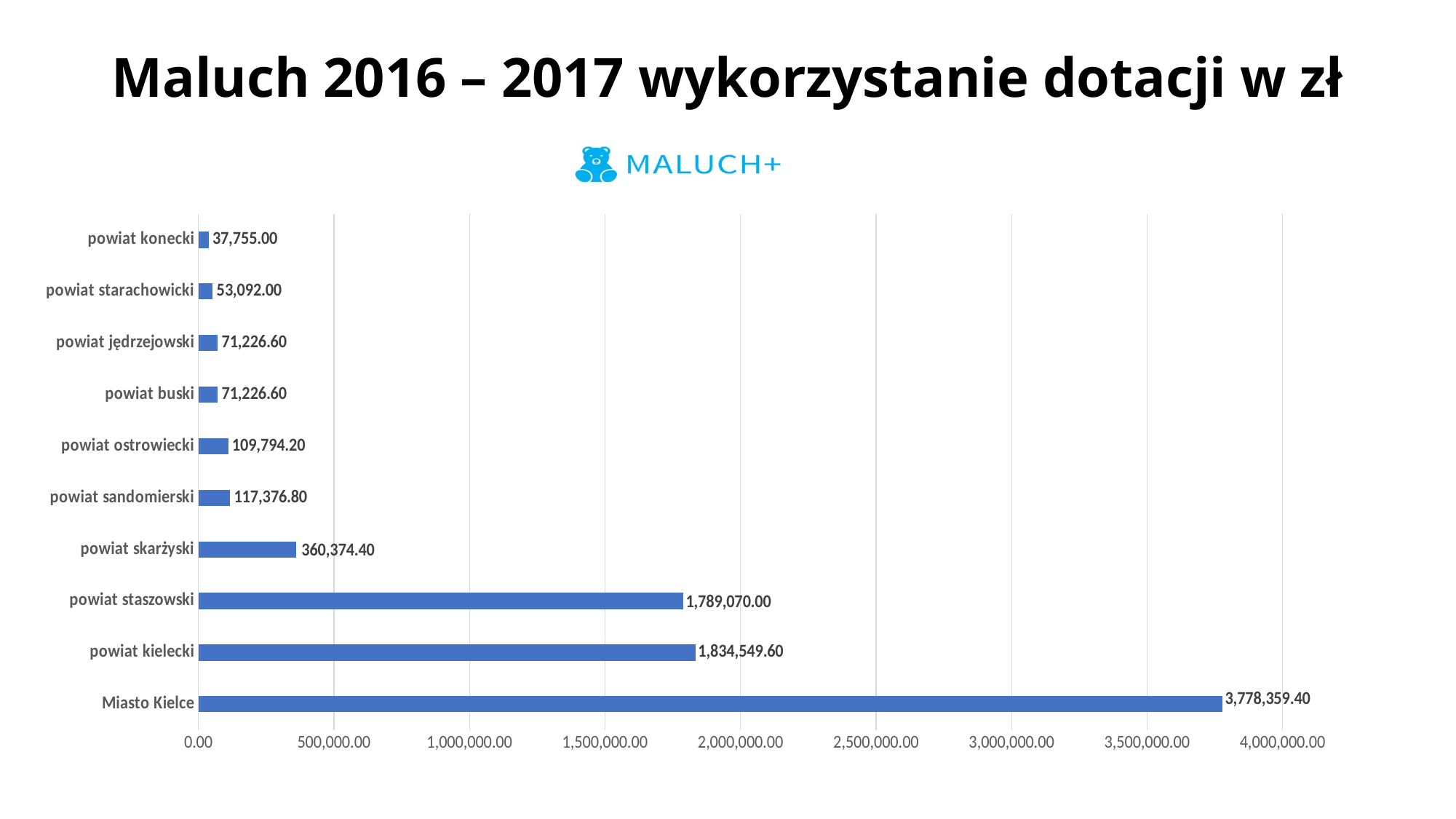
Which is larger, the value for powiat kielecki or powiat staszowski? powiat kielecki Is the value for powiat skarżyski greater or less than 500,000.00? less How many categories are shown in the chart? 10 What is the value for powiat skarżyski? 360,374.40 Which category has the lowest value? powiat konecki What is the value for powiat ostrowiecki? 109,794.20 What type of chart is shown on the slide? bar chart What is the value for Miasto Kielce? 3,778,359.40 Which category has the highest value? Miasto Kielce What is the value for powiat starachowicki? 53,092.00 What is the difference between the values for powiat sandomierski and powiat ostrowiecki? 7,582.60 What is the difference between the values for Miasto Kielce and powiat kielecki? 1,943,809.80